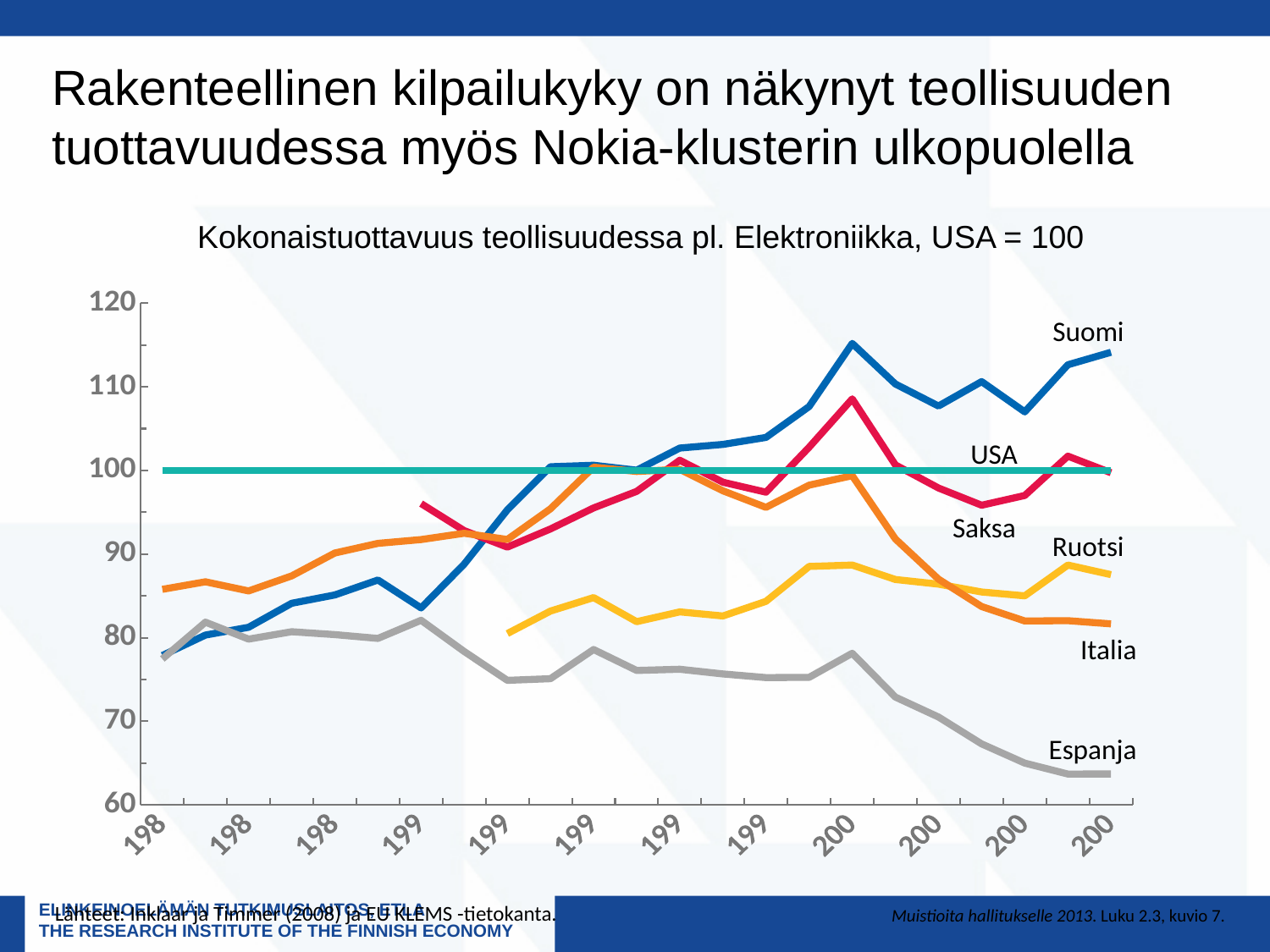
Does the Suomi line generally rise or fall from left to right? rise How many series (countries) are labelled on the chart? 6 Is the value for Suomi at the right end of the chart greater or less than 110? greater Which series has the lowest value at the right end of the chart? Espanja Does the Espanja line generally rise or fall from left to right? fall Which series has the highest value at the right end of the chart? Suomi At what constant value does the USA line run across the chart? 100 What is the title of the chart? Kokonaistuottavuus teollisuudessa pl. Elektroniikka, USA = 100 At the right end of the chart, which is higher, Ruotsi or Italia? Ruotsi Is the value for Espanja at the right end of the chart greater or less than 70? less What kind of chart is shown on the slide? line chart Is the value for Italia at the right end of the chart greater or less than 90? less